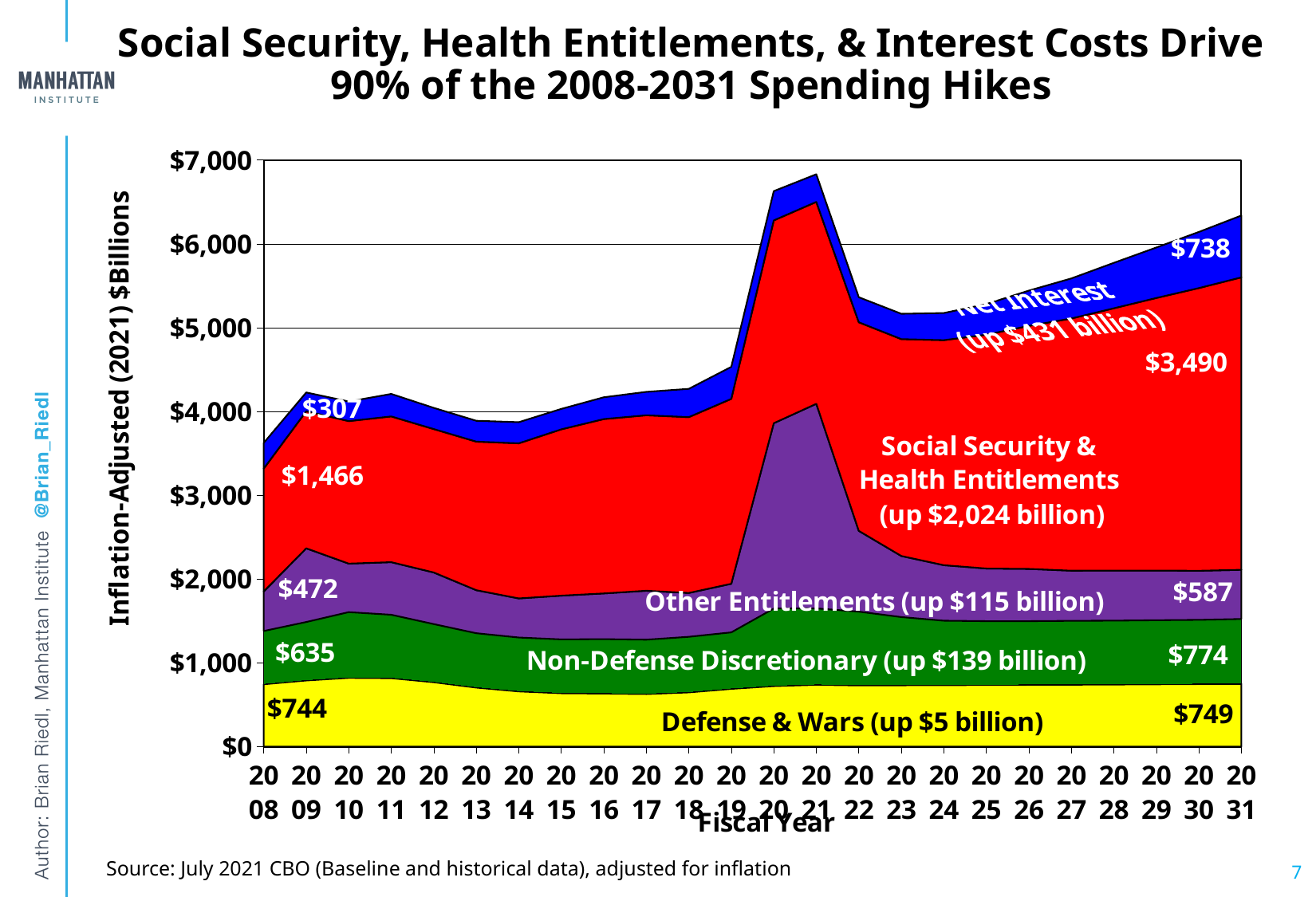
What is the value for Net Interest in fiscal year 2008? $307 Which spending category has the smallest value in fiscal year 2008? Net Interest What is the total of all five categories in fiscal year 2008? $3,624 How many fiscal years are shown on the x axis? 24 What is the value for Defense & Wars in fiscal year 2008? $744 In fiscal year 2031, which is larger: Non-Defense Discretionary or Defense & Wars? Non-Defense Discretionary Which spending category has the largest value in fiscal year 2031? Social Security & Health Entitlements By how much does Net Interest increase from 2008 to 2031? $431 What is the value for Social Security & Health Entitlements in fiscal year 2031? $3,490 Is total spending in fiscal year 2021 greater or less than $6,000? greater What is the value for Other Entitlements in fiscal year 2031? $587 What kind of chart is shown on the slide? Stacked area chart